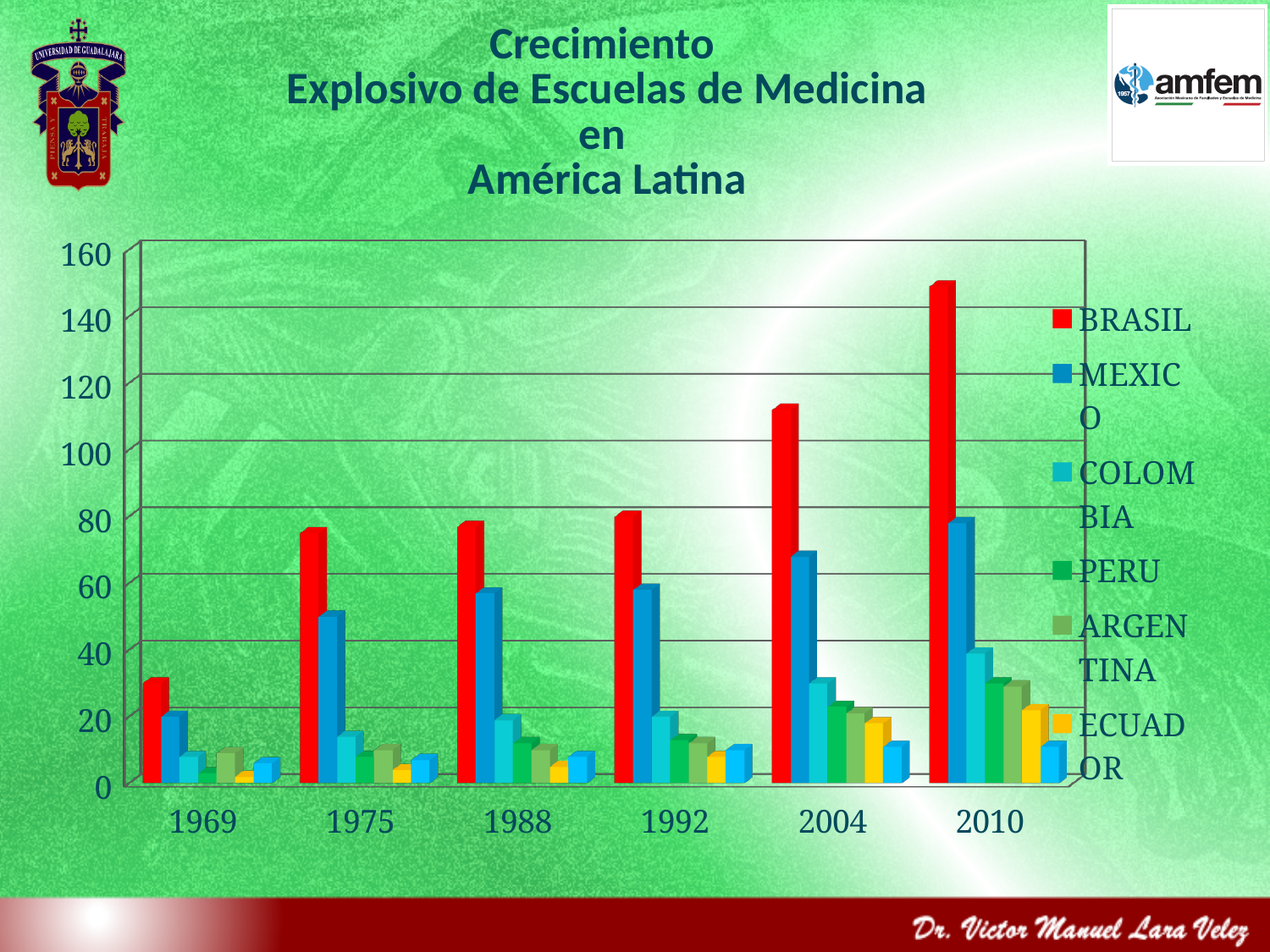
Which country has the tallest bar in 2010? BRASIL How many series does the chart's legend list? 6 Which is larger in 2010, the value for MEXICO or the value for COLOMBIA? MEXICO What kind of chart is shown on the slide? bar chart Is the value for BRASIL in 2010 greater or less than 140? greater In which year is the BRASIL bar highest? 2010 How many years are shown on the x axis of the chart? 6 Is the value for BRASIL in 1969 greater or less than 40? less Is the value for BRASIL in 2004 greater or less than 100? greater Do the BRASIL values rise or fall from 1969 to 2010? rise In which year is the BRASIL bar lowest? 1969